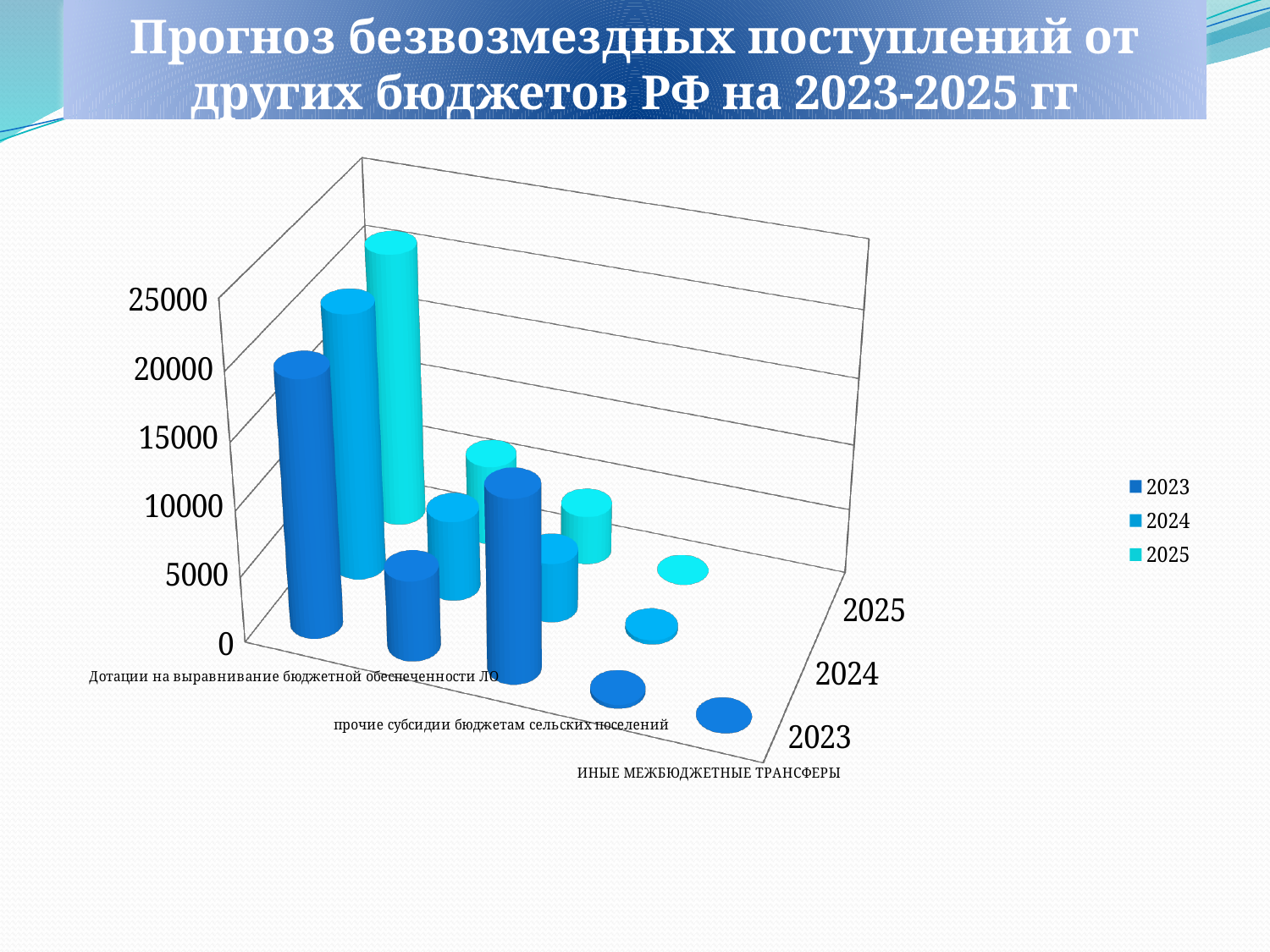
How many categories are shown along the category axis? 5 Is the 2023 value for прочие субсидии бюджетам сельских поселений greater or less than 20000? less Which years are listed in the chart legend? 2023, 2024, 2025 What kind of chart is shown on the slide? bar chart For 2025, which is larger: прочие субсидии бюджетам сельских поселений or ИНЫЕ МЕЖБЮДЖЕТНЫЕ ТРАНСФЕРЫ? прочие субсидии бюджетам сельских поселений What is the highest value shown on the vertical axis? 25000 Which category has the highest values in the chart? Дотации на выравнивание бюджетной обеспеченности ЛО Which category has the lowest values in the chart? ИНЫЕ МЕЖБЮДЖЕТНЫЕ ТРАНСФЕРЫ For 2023, which is larger: Дотации на выравнивание бюджетной обеспеченности ЛО or прочие субсидии бюджетам сельских поселений? Дотации на выравнивание бюджетной обеспеченности ЛО Is the 2023 value for Дотации на выравнивание бюджетной обеспеченности ЛО greater or less than 15000? greater How many series does the legend list? 3 Is the 2023 value for ИНЫЕ МЕЖБЮДЖЕТНЫЕ ТРАНСФЕРЫ greater or less than 5000? less